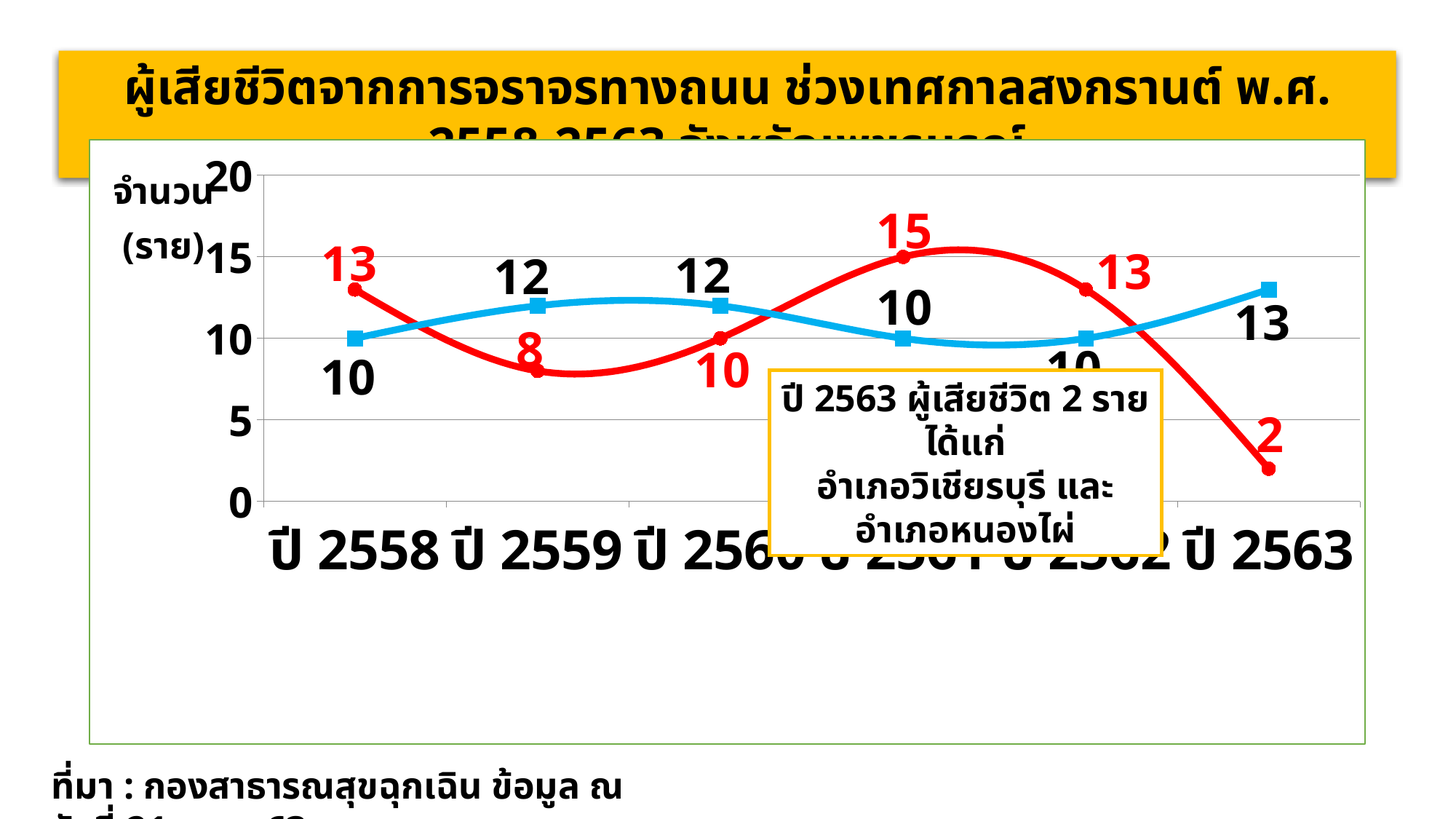
What is the value of the red line for ปี 2563? 2 Does the red line rise or fall from ปี 2562 to ปี 2563? fall What is the value of the blue line for ปี 2559? 12 In which year does the red line reach its lowest value? ปี 2563 What kind of chart is shown on the slide? line chart What is the value of the blue line for ปี 2563? 13 In which year does the blue line reach its highest value? ปี 2563 What is the value of the red line for ปี 2558? 13 In which year does the red line reach its highest value? ปี 2561 What is the difference between the red line's value for ปี 2561 and its value for ปี 2563? 13 How many years (categories) are plotted along the x axis? 6 For ปี 2559, which line has the larger value, the red line or the blue line? blue line